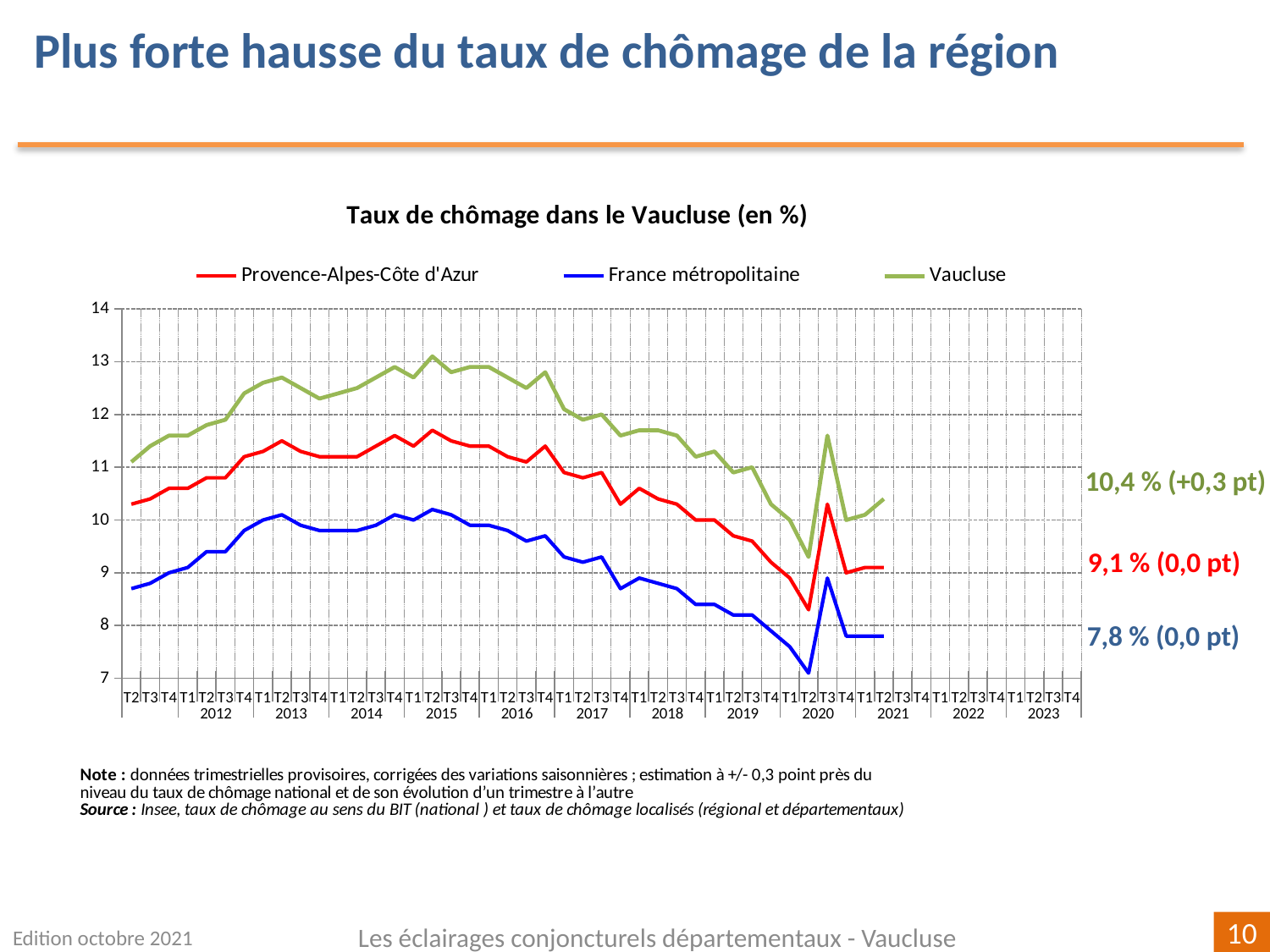
What is the latest unemployment rate shown for Vaucluse? 10,4 % What is the latest unemployment rate shown for Provence-Alpes-Côte d'Azur? 9,1 % Which series has the highest values across the whole period? Vaucluse What is the latest unemployment rate shown for France métropolitaine? 7,8 % Does the Vaucluse series rise or fall between T2 2015 and T2 2019? Fall What is the title of the chart? Taux de chômage dans le Vaucluse (en %) Is the value for France métropolitaine in T2 2020 greater or less than 8? less What is the difference between the latest Vaucluse rate and the latest France métropolitaine rate? 2,6 points How many series does the legend list? 3 What kind of chart is shown on the slide? Line chart What is the quarterly change shown next to the latest Vaucluse value? +0,3 pt Which series has the lowest values across the whole period? France métropolitaine